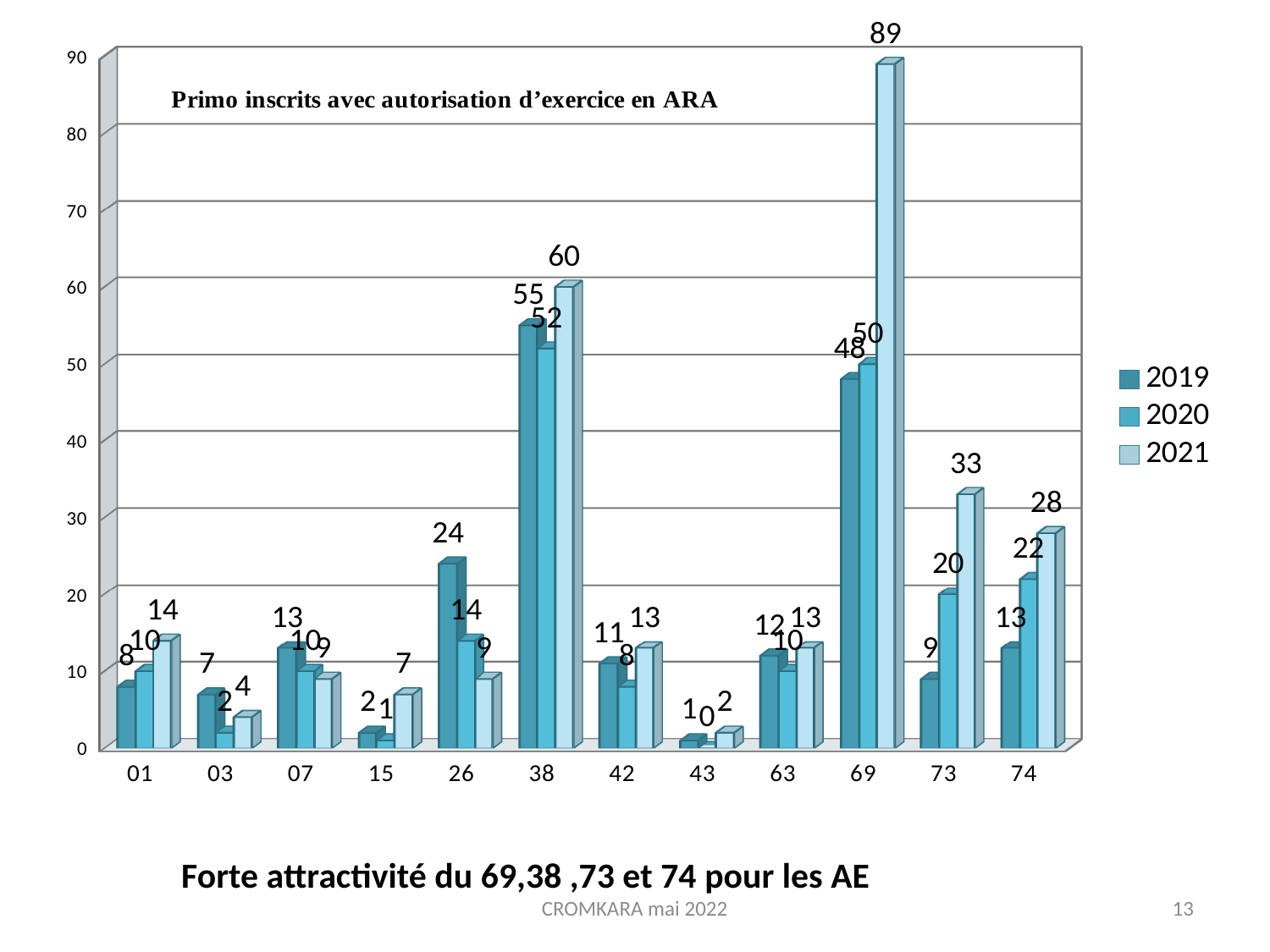
Does the value for category 74 rise or fall from 2019 to 2021? rise Which category has the lowest value for the 2020 series? 43 How many series does the legend list? 3 How many categories are shown on the x axis? 12 What is the difference between the 2021 and 2019 values in category 69? 41 What is the value for 2020 in category 73? 20 What is the value for 2021 in category 69? 89 What kind of chart is shown on the slide? bar chart What is the title of the chart? Primo inscrits avec autorisation d’exercice en ARA Which is larger in category 26: the 2019 value or the 2021 value? 2019 Which category has the highest value for the 2021 series? 69 What is the value for 2019 in category 38? 55